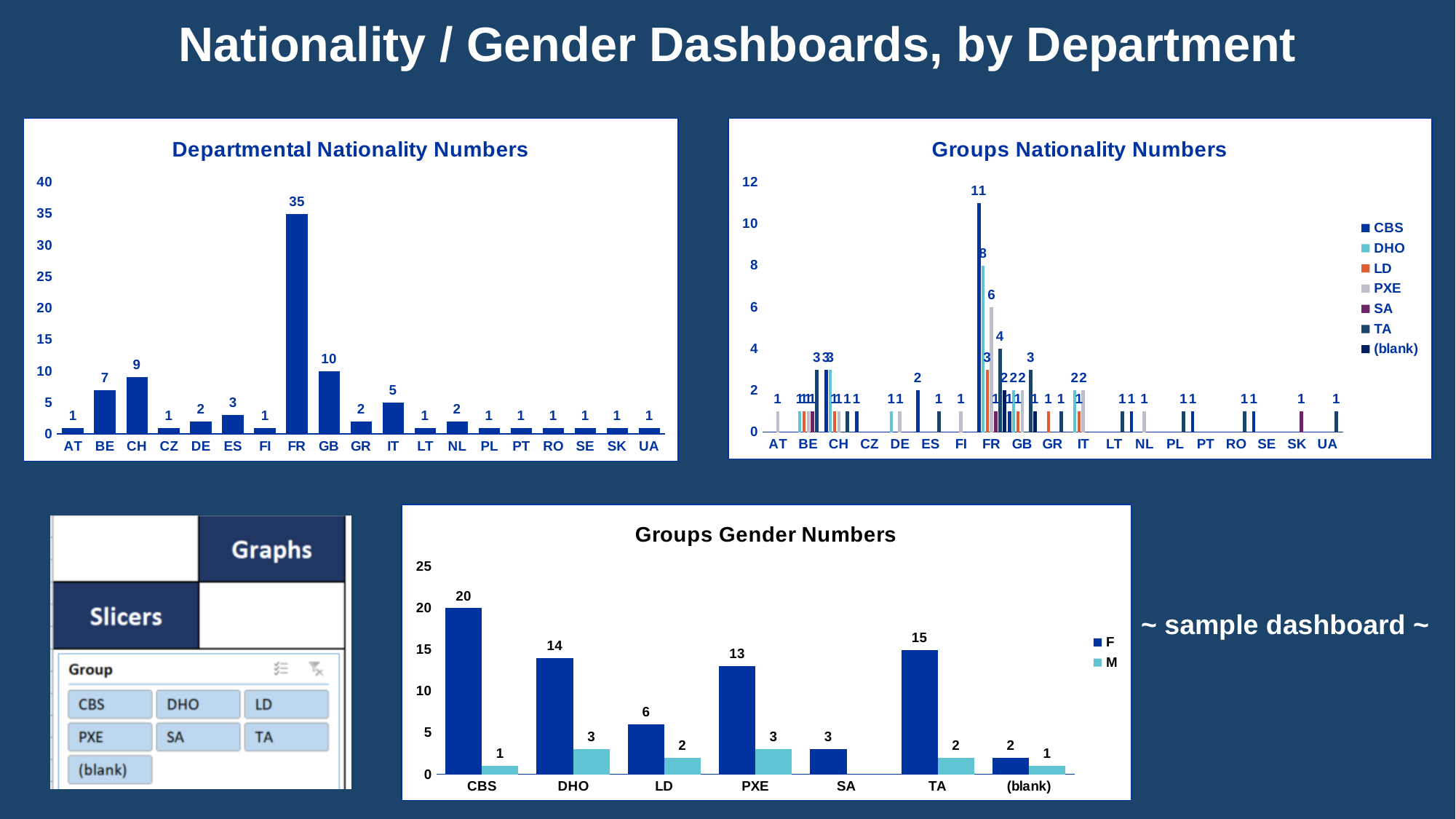
How many series does the legend of the Groups Nationality Numbers chart list? 7 In the Groups Gender Numbers chart, which group has the highest F value? CBS How many nationality categories are shown on the x axis of the Departmental Nationality Numbers chart? 19 In the Groups Nationality Numbers chart, what is the value of the tallest bar, for CBS at FR? 11 In the Departmental Nationality Numbers chart, which nationality has the highest value? FR In the Groups Gender Numbers chart, what is the F value for CBS? 20 In the Departmental Nationality Numbers chart, what is the difference between the values for FR and GB? 25 In the Departmental Nationality Numbers chart, which is larger, the value for BE or the value for CH? CH In the Departmental Nationality Numbers chart, what is the value for FR? 35 In the Groups Gender Numbers chart, what is the M value for DHO? 3 What kind of chart is the Departmental Nationality Numbers chart? Bar chart In the Groups Gender Numbers chart, what is the difference between the F and M values for CBS? 19